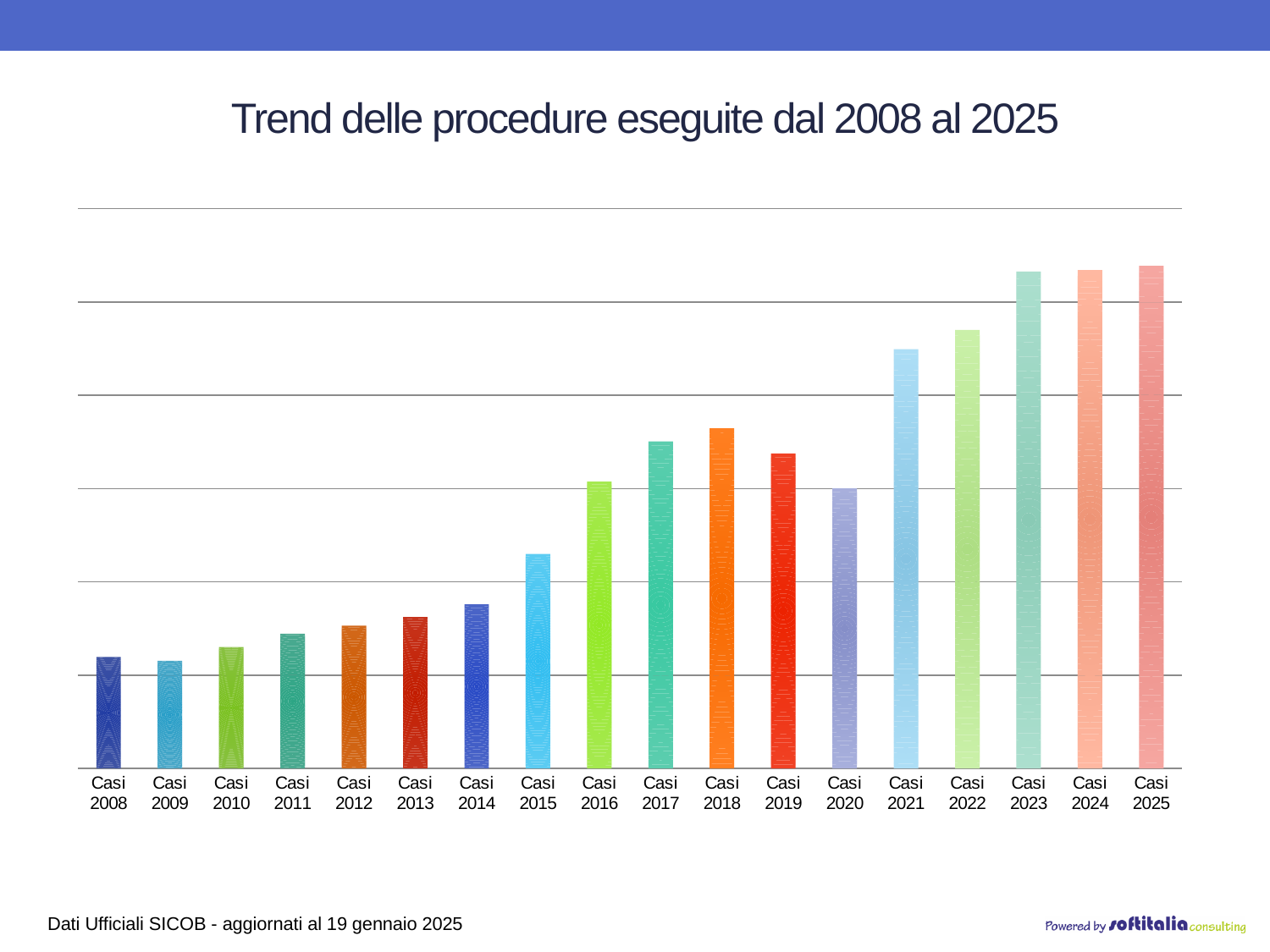
Does the value rise or fall from Casi 2020 to Casi 2021? Rise What is the title of the chart? Trend delle procedure eseguite dal 2008 al 2025 Which is larger, the value for Casi 2021 or Casi 2022? Casi 2022 Does the value rise or fall from Casi 2019 to Casi 2020? Fall Which is larger, the value for Casi 2018 or Casi 2019? Casi 2018 What data source is cited at the bottom of the slide? Dati Ufficiali SICOB - aggiornati al 19 gennaio 2025 Do the values generally rise or fall from Casi 2008 to Casi 2025? Rise Which is larger, the value for Casi 2015 or Casi 2016? Casi 2016 What kind of chart is shown on the slide? Bar chart How many categories (years) are plotted on the chart? 18